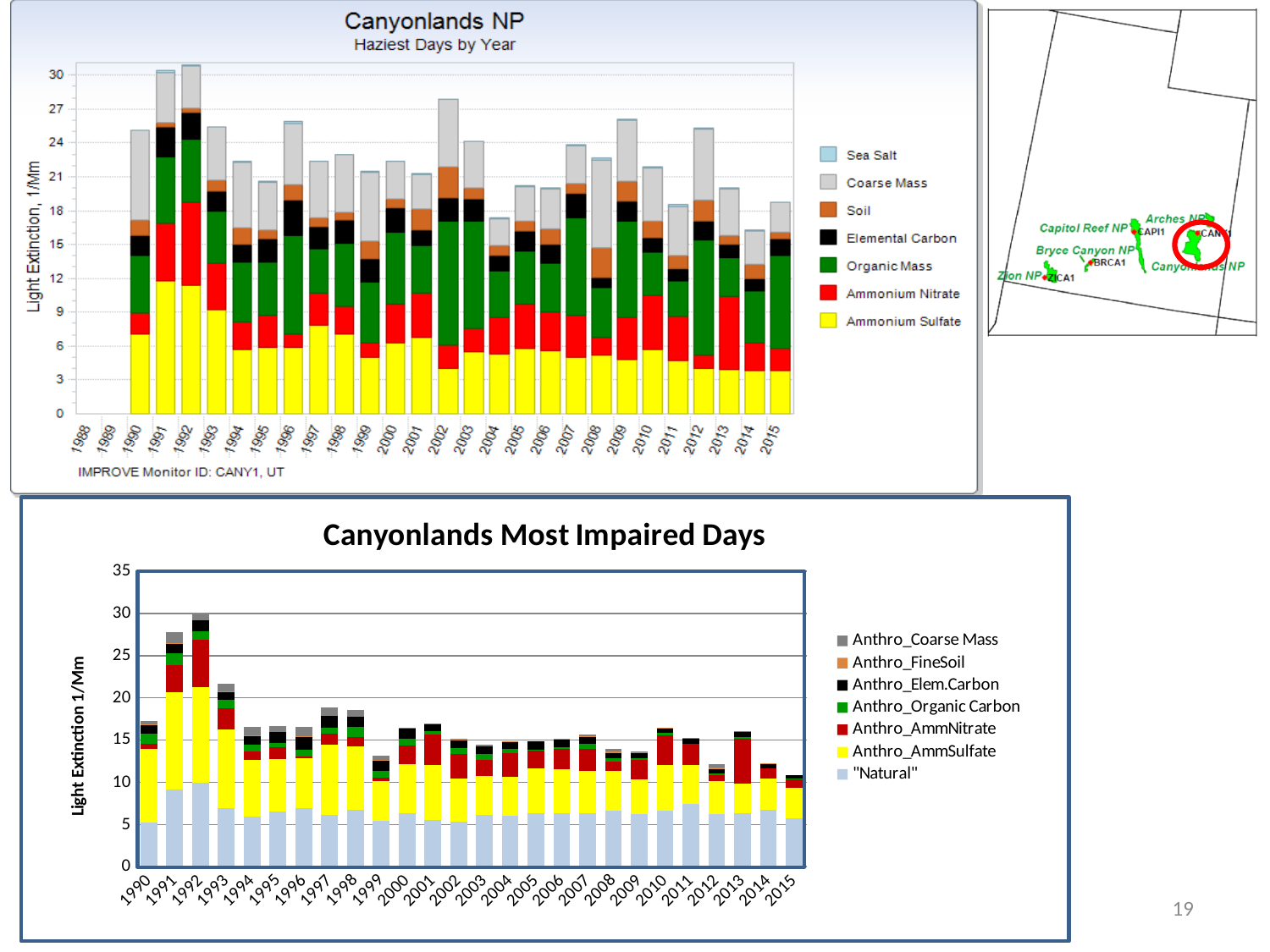
In the 'Canyonlands Most Impaired Days' chart, which year has the tallest bar? 1992 In the 'Canyonlands NP Haziest Days by Year' chart, is the total bar for 2002 greater or less than 24? greater How many series does the legend of the 'Canyonlands NP Haziest Days by Year' chart list? 7 In the 'Canyonlands Most Impaired Days' chart, which bar is taller, 2012 or 2013? 2013 What kind of chart is the 'Canyonlands Most Impaired Days' chart? Stacked bar chart In the 'Canyonlands Most Impaired Days' chart, is the total bar for 1999 greater or less than 15? less In the 'Canyonlands Most Impaired Days' chart, which year has the shortest bar? 2015 How many years have bars in the 'Canyonlands Most Impaired Days' chart? 26 How many series does the legend of the 'Canyonlands Most Impaired Days' chart list? 7 What is the y-axis label of the 'Canyonlands NP Haziest Days by Year' chart? Light Extinction, 1/Mm In the 'Canyonlands NP Haziest Days by Year' chart, is the total bar for 2014 greater or less than 18? less